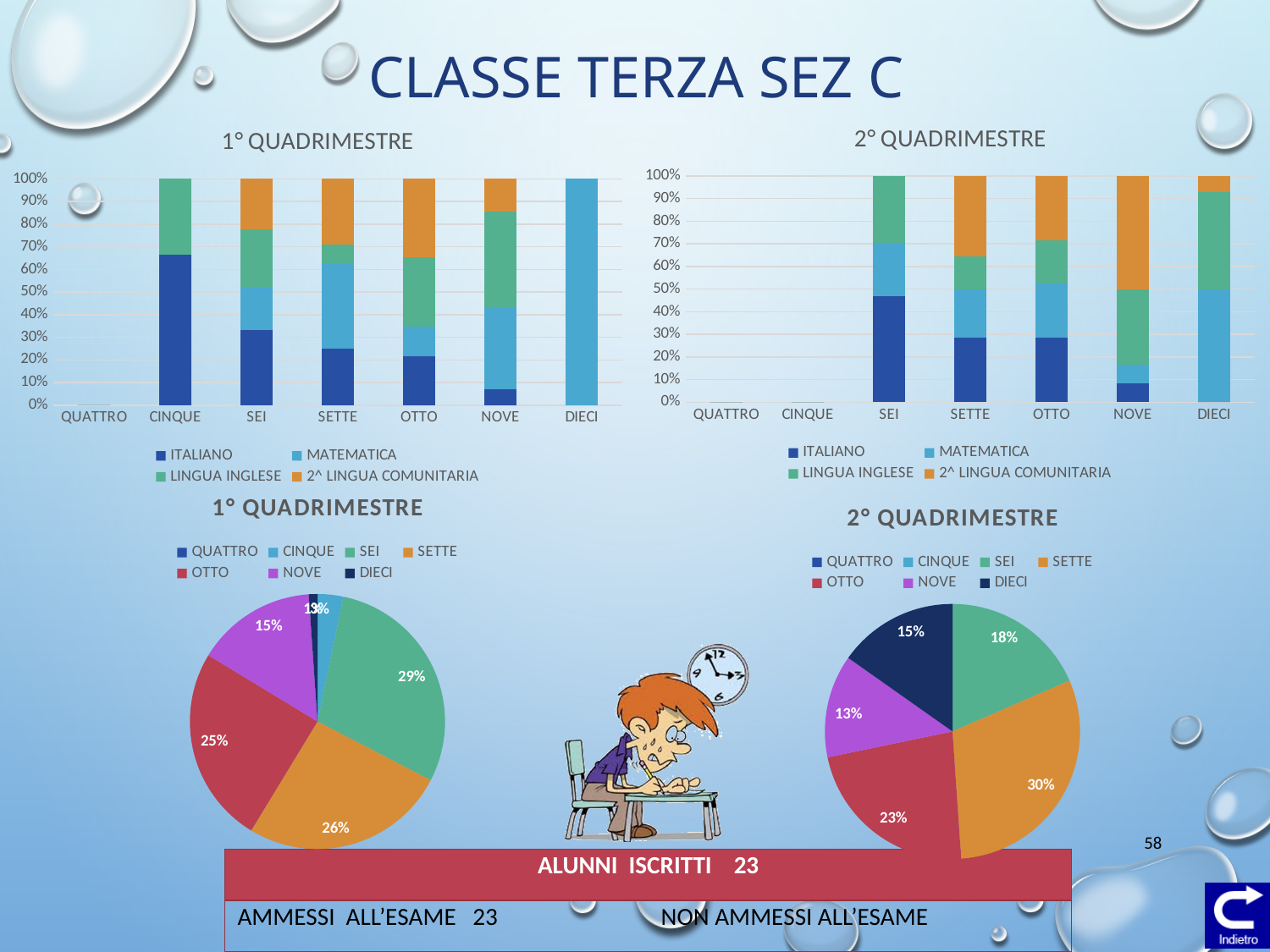
In the 2° QUADRIMESTRE pie chart at the bottom right, which category has the smallest slice? NOVE What kind of chart is the 1° QUADRIMESTRE chart at the top left of the slide? Stacked bar chart In the 1° QUADRIMESTRE pie chart at the bottom left, what share does SEI have? 29% In the 1° QUADRIMESTRE bar chart at the top left, how many series does the legend list? 4 In the 2° QUADRIMESTRE bar chart at the top right, how many categories are shown on the x axis? 7 In the 1° QUADRIMESTRE pie chart at the bottom left, which category has the largest slice? SEI In the 1° QUADRIMESTRE pie chart at the bottom left, which is larger, the SETTE slice or the OTTO slice? SETTE In the 2° QUADRIMESTRE pie chart at the bottom right, what share does SETTE have? 30% In the 2° QUADRIMESTRE bar chart at the top right, which colour represents MATEMATICA in the legend? Light blue In the 2° QUADRIMESTRE bar chart at the top right, is the ITALIANO value for NOVE greater or less than 20%? less In the 2° QUADRIMESTRE pie chart at the bottom right, what is the difference between the SETTE share and the OTTO share? 7% In the 1° QUADRIMESTRE bar chart at the top left, is the ITALIANO value for CINQUE greater or less than 50%? greater